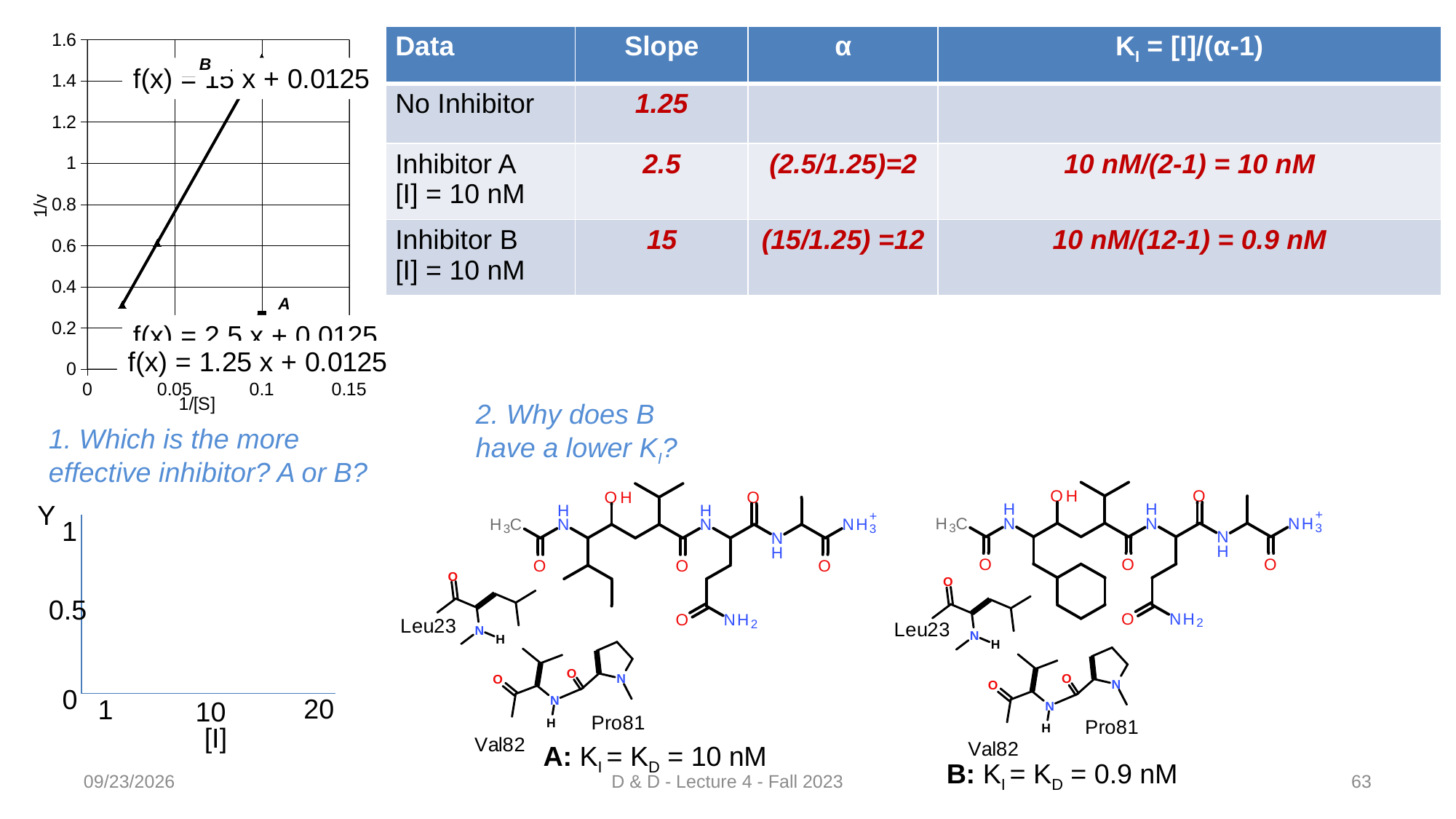
On the top-left chart, does 1/v rise or fall as 1/[S] increases? rise On the top-left chart, how many trendline equations are printed? 3 On the top-left chart, which labelled line, A or B, is steeper? B On the top-left chart, what is the slope of line B according to its printed trendline equation? 15 On the top-left chart, what is the highest tick value shown on the x axis? 0.15 On the bottom-left chart, what is the label of the x axis? [I] On the top-left chart, what is the slope of line A according to its printed trendline equation? 2.5 On the top-left chart, what is the y-intercept shared by the three printed trendline equations? 0.0125 On the top-left chart, what is the highest tick value shown on the y axis? 1.6 On the top-left chart, what is the label of the y axis? 1/v On the top-left chart, what is the label of the x axis? 1/[S] On the top-left chart, what is the difference between the slopes of line B and line A as given by the trendline equations? 12.5